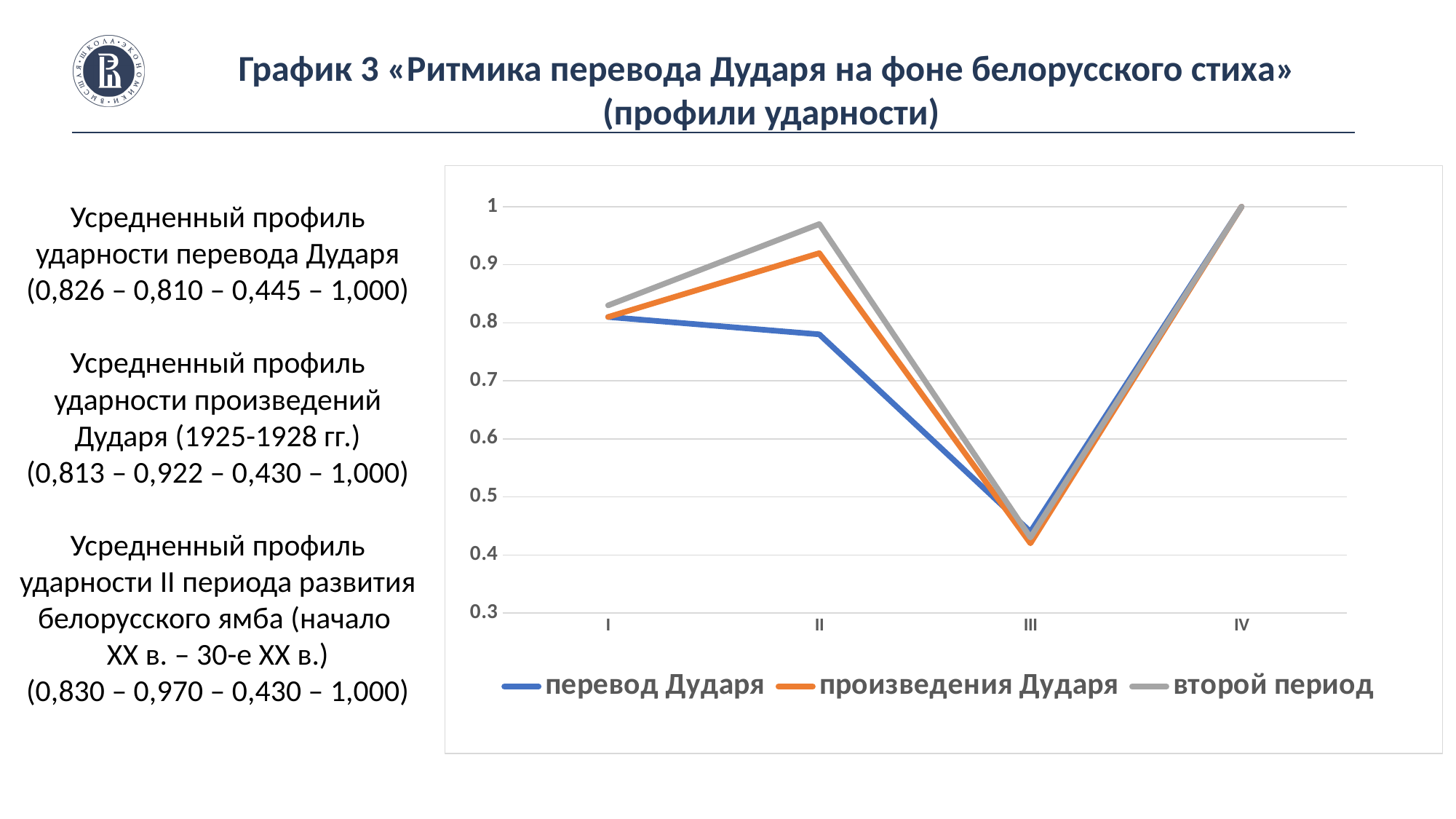
What colour is the line for 'произведения Дударя' in the chart? orange What type of chart is shown on the slide? line chart Does the 'перевод Дударя' series rise or fall from position II to position III? fall Is the value of 'произведения Дударя' at position III greater or less than 0.5? less At position II, which series has the higher value: 'перевод Дударя' or 'второй период'? второй период How many series does the legend of the chart list? 3 Is the value of 'перевод Дударя' at position II greater or less than 0.8? less At which position does the 'второй период' series reach its lowest value? III At which position does the 'произведения Дударя' series reach its highest value? IV What is the value of the 'перевод Дударя' series at position IV? 1 How many positions are plotted along the x axis of the chart? 4 Is the value of 'второй период' at position II greater or less than 0.9? greater